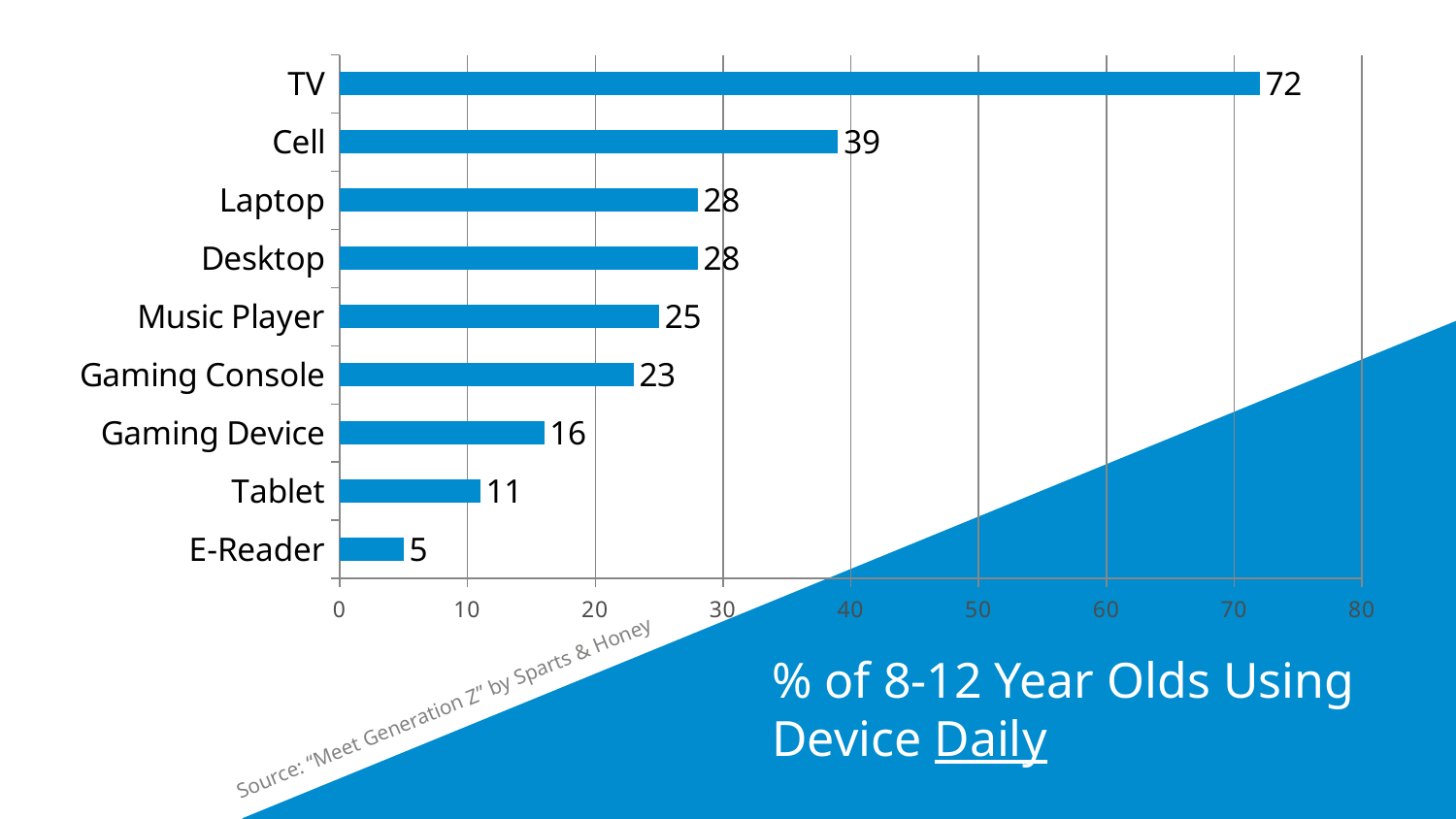
Which is larger, the value for Cell or the value for Music Player? Cell What is the difference between the values for TV and Cell? 33 What is the value for Gaming Console? 23 What kind of chart is shown on the slide? Bar chart What is the title of the chart? % of 8-12 Year Olds Using Device Daily Which device has the lowest value? E-Reader Which device has the highest value? TV What is the value for Tablet? 11 How many devices are shown in the chart? 9 Is the value for Cell greater or less than 30? greater What is the value for TV? 72 What is the difference between the values for Gaming Device and Tablet? 5